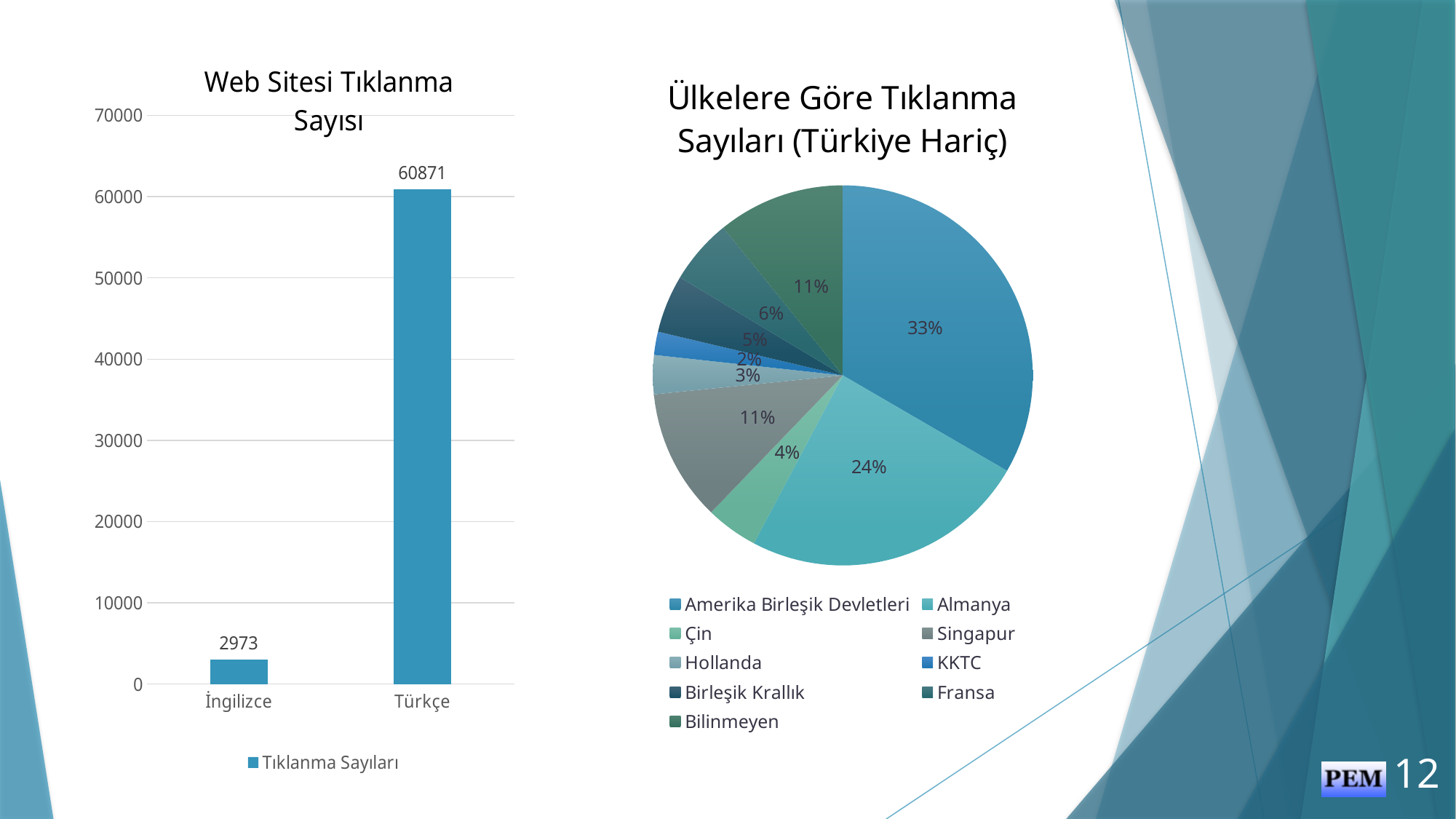
In the 'Ülkelere Göre Tıklanma Sayıları (Türkiye Hariç)' chart, what share does Amerika Birleşik Devletleri have? 33% In the 'Web Sitesi Tıklanma Sayısı' chart, what is the value for Türkçe? 60871 In the 'Ülkelere Göre Tıklanma Sayıları (Türkiye Hariç)' chart, which is larger, the slice for Fransa or the slice for Çin? Fransa In the 'Web Sitesi Tıklanma Sayısı' chart, which category has the highest value? Türkçe In the 'Web Sitesi Tıklanma Sayısı' chart, how many categories are shown on the x axis? 2 In the 'Ülkelere Göre Tıklanma Sayıları (Türkiye Hariç)' chart, which country has the smallest slice? KKTC In the 'Web Sitesi Tıklanma Sayısı' chart, what is the difference between the Türkçe and İngilizce values? 57898 How many entries does the legend of the 'Ülkelere Göre Tıklanma Sayıları (Türkiye Hariç)' chart list? 9 In the 'Ülkelere Göre Tıklanma Sayıları (Türkiye Hariç)' chart, what share does Almanya have? 24% What kind of chart is 'Web Sitesi Tıklanma Sayısı'? Bar chart In the 'Web Sitesi Tıklanma Sayısı' chart, what is the value for İngilizce? 2973 What kind of chart is 'Ülkelere Göre Tıklanma Sayıları (Türkiye Hariç)'? Pie chart